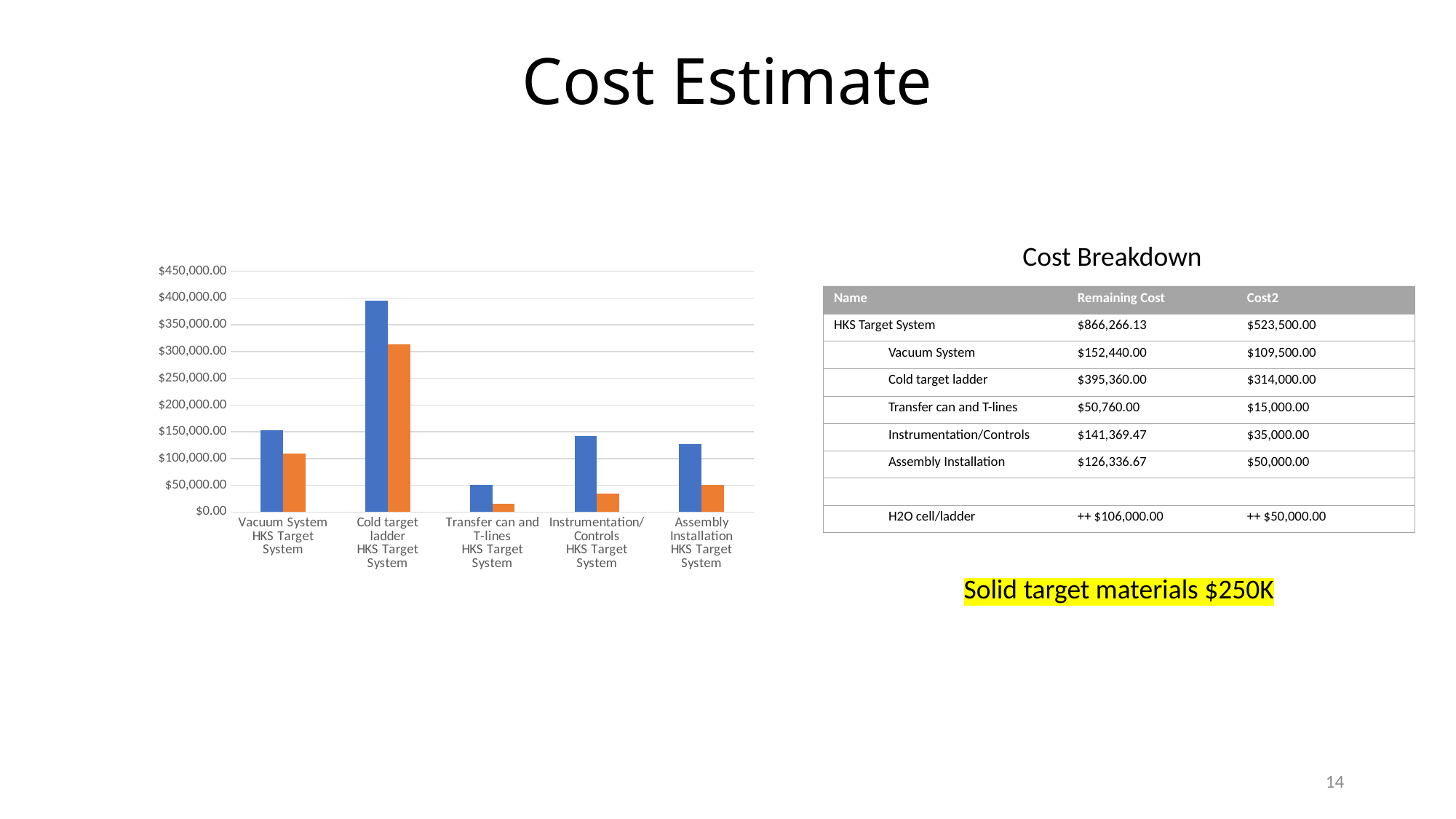
Is the blue bar for Vacuum System greater or less than $100,000.00? greater Is the orange bar for Transfer can and T-lines greater or less than $50,000.00? less Is the orange bar for Instrumentation/Controls greater or less than $50,000.00? less How many categories are shown on the x axis of the bar chart? 5 Which category has the shortest orange bar in the chart? Transfer can and T-lines HKS Target System What is the highest value labelled on the y axis of the chart? $450,000.00 Which category has the shortest blue bar in the chart? Transfer can and T-lines HKS Target System Which category has the tallest orange bar in the chart? Cold target ladder HKS Target System Which is larger, the orange bar for Vacuum System or the orange bar for Assembly Installation? Vacuum System What kind of chart is shown on the left of the slide? bar chart Which category has the tallest blue bar in the chart? Cold target ladder HKS Target System